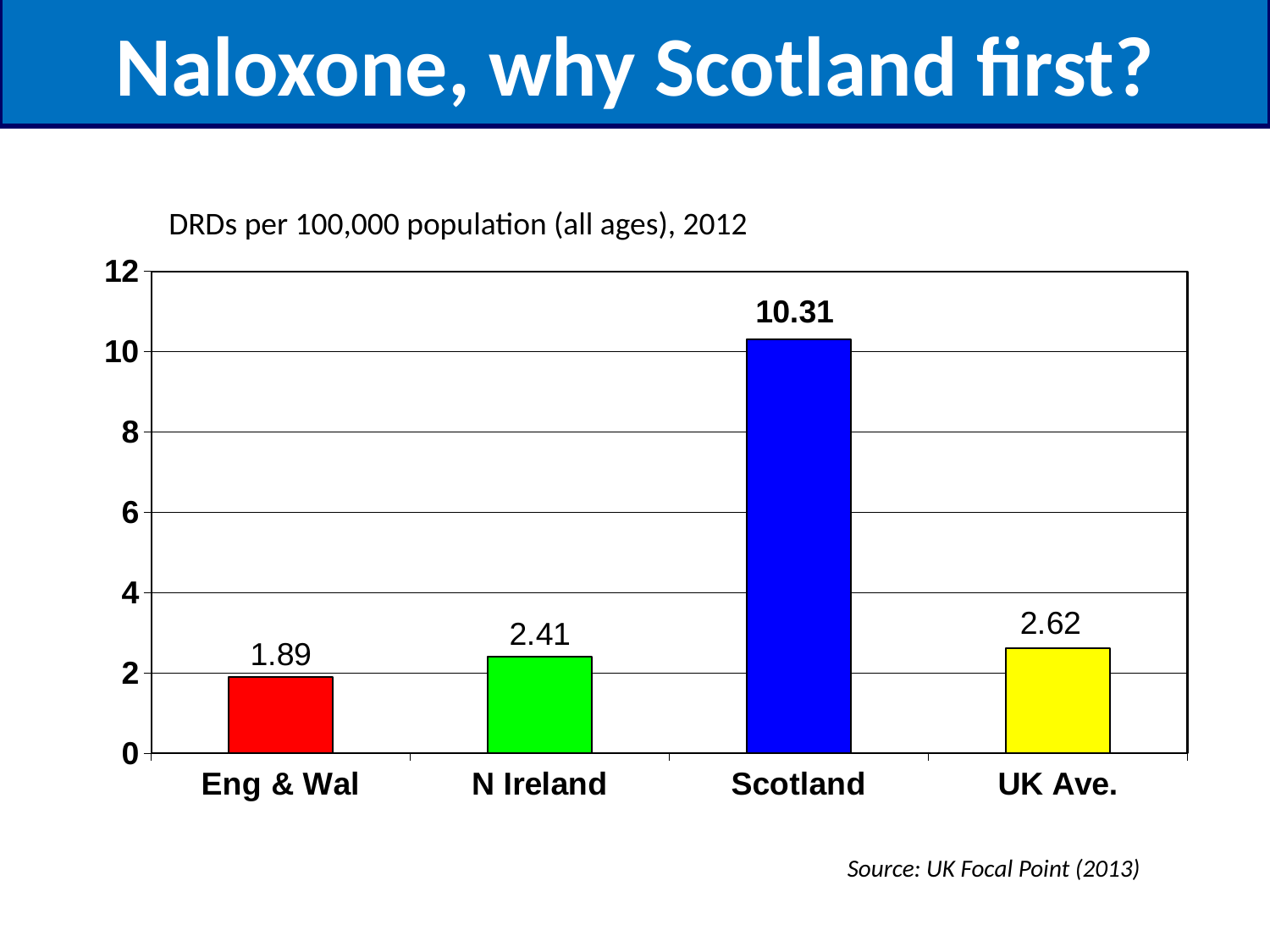
How many categories are shown on the x axis? 4 What is the value for Eng & Wal? 1.89 Which is larger, the value for N Ireland or the value for UK Ave.? UK Ave. What is the value for N Ireland? 2.41 Which category has the highest value? Scotland Which category has the lowest value? Eng & Wal What is the difference between the values for Scotland and UK Ave.? 7.69 What kind of chart is shown on the slide? bar chart What is the value for Scotland? 10.31 What is the difference between the values for N Ireland and Eng & Wal? 0.52 What is the value for UK Ave.? 2.62 Is the value for Scotland greater or less than 10? greater